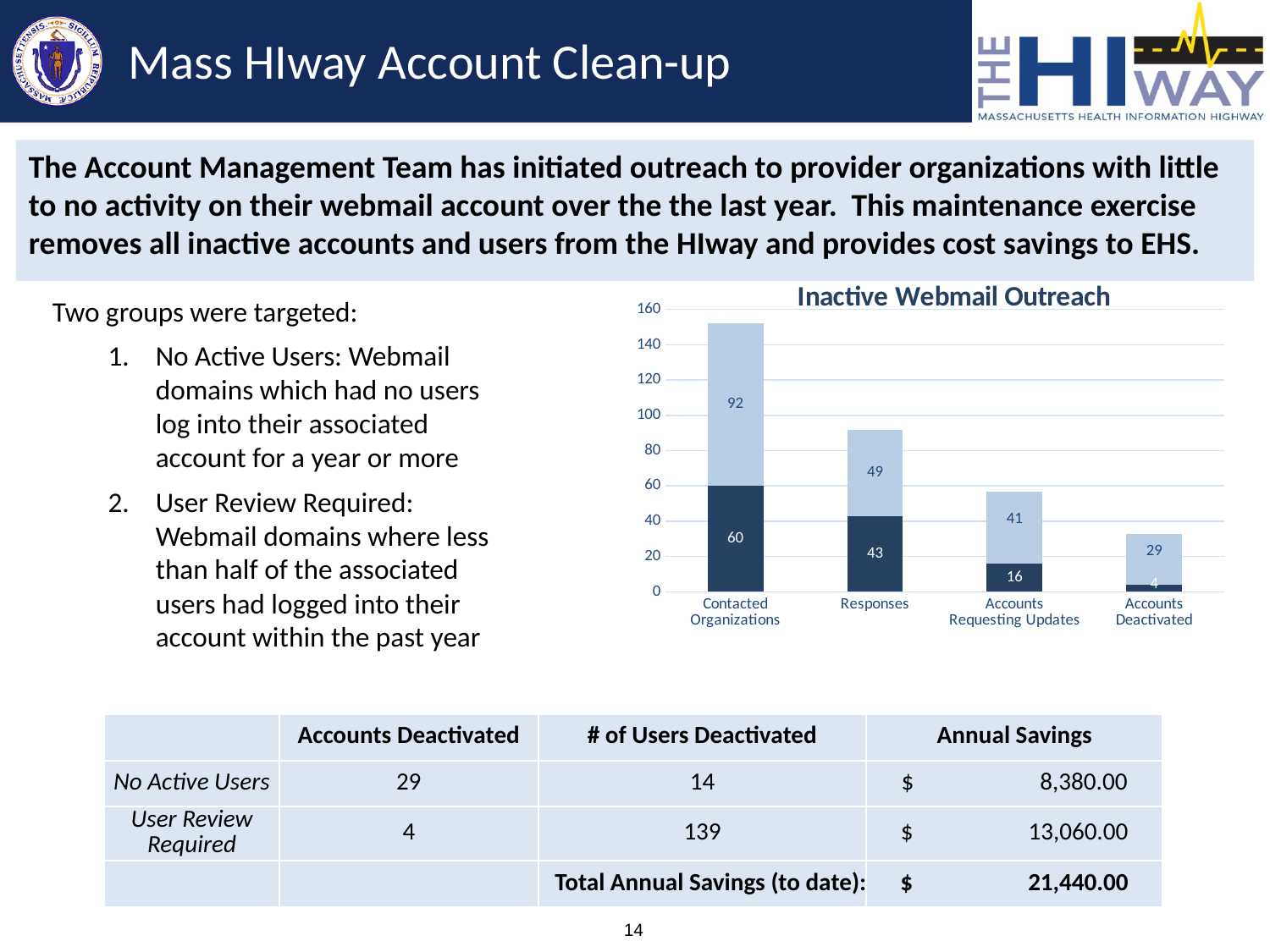
What is the difference between the light blue segment for Accounts Requesting Updates and the light blue segment for Accounts Deactivated? 12 What type of chart is shown on the slide? stacked bar chart What is the total of the stacked bar for Accounts Requesting Updates? 57 How many categories are shown on the x axis of the chart? 4 What is the value of the dark blue segment for Accounts Deactivated? 4 What is the total of the stacked bar for Contacted Organizations? 152 What is the value of the dark blue segment for Contacted Organizations? 60 What is the value of the light blue segment for Responses? 49 Which category has the tallest stacked bar? Contacted Organizations Which category has the shortest stacked bar? Accounts Deactivated Do the stacked bar totals rise or fall from left to right across the x axis? fall What is the title of the chart? Inactive Webmail Outreach